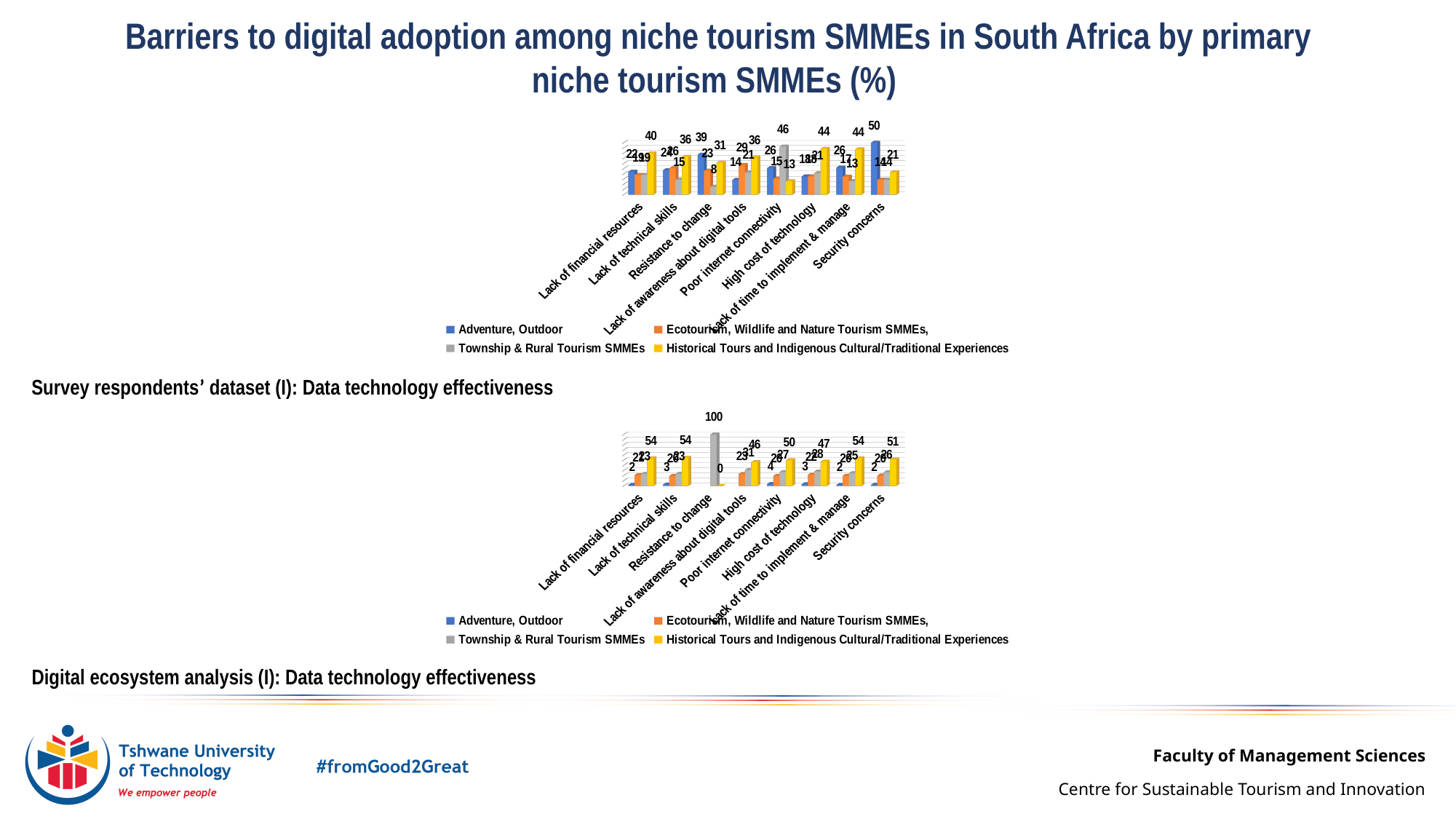
In the top chart (Survey respondents' dataset), what is the value for Township & Rural Tourism SMMEs under Poor internet connectivity? 46 How many series does the legend of the bottom chart (Digital ecosystem analysis) list? 4 In the top chart (Survey respondents' dataset), what is the value for Township & Rural Tourism SMMEs under Resistance to change? 8 In the bottom chart (Digital ecosystem analysis), what is the value for Township & Rural Tourism SMMEs under Resistance to change? 100 In the bottom chart (Digital ecosystem analysis), what is the value for Historical Tours and Indigenous Cultural/Traditional Experiences under Poor internet connectivity? 50 What kind of chart is the top chart (Survey respondents' dataset)? Bar chart In the top chart (Survey respondents' dataset), what is the difference between the Adventure, Outdoor value and the Historical Tours and Indigenous Cultural/Traditional Experiences value under Security concerns? 29 In the top chart (Survey respondents' dataset), what is the value for Adventure, Outdoor under Security concerns? 50 In the top chart (Survey respondents' dataset), under Resistance to change, which is larger: Adventure, Outdoor or Township & Rural Tourism SMMEs? Adventure, Outdoor In the bottom chart (Digital ecosystem analysis), which series and category has the highest value? Township & Rural Tourism SMMEs, Resistance to change In the top chart (Survey respondents' dataset), what is the value for Historical Tours and Indigenous Cultural/Traditional Experiences under High cost of technology? 44 How many barrier categories are shown on the x axis of the top chart (Survey respondents' dataset)? 8